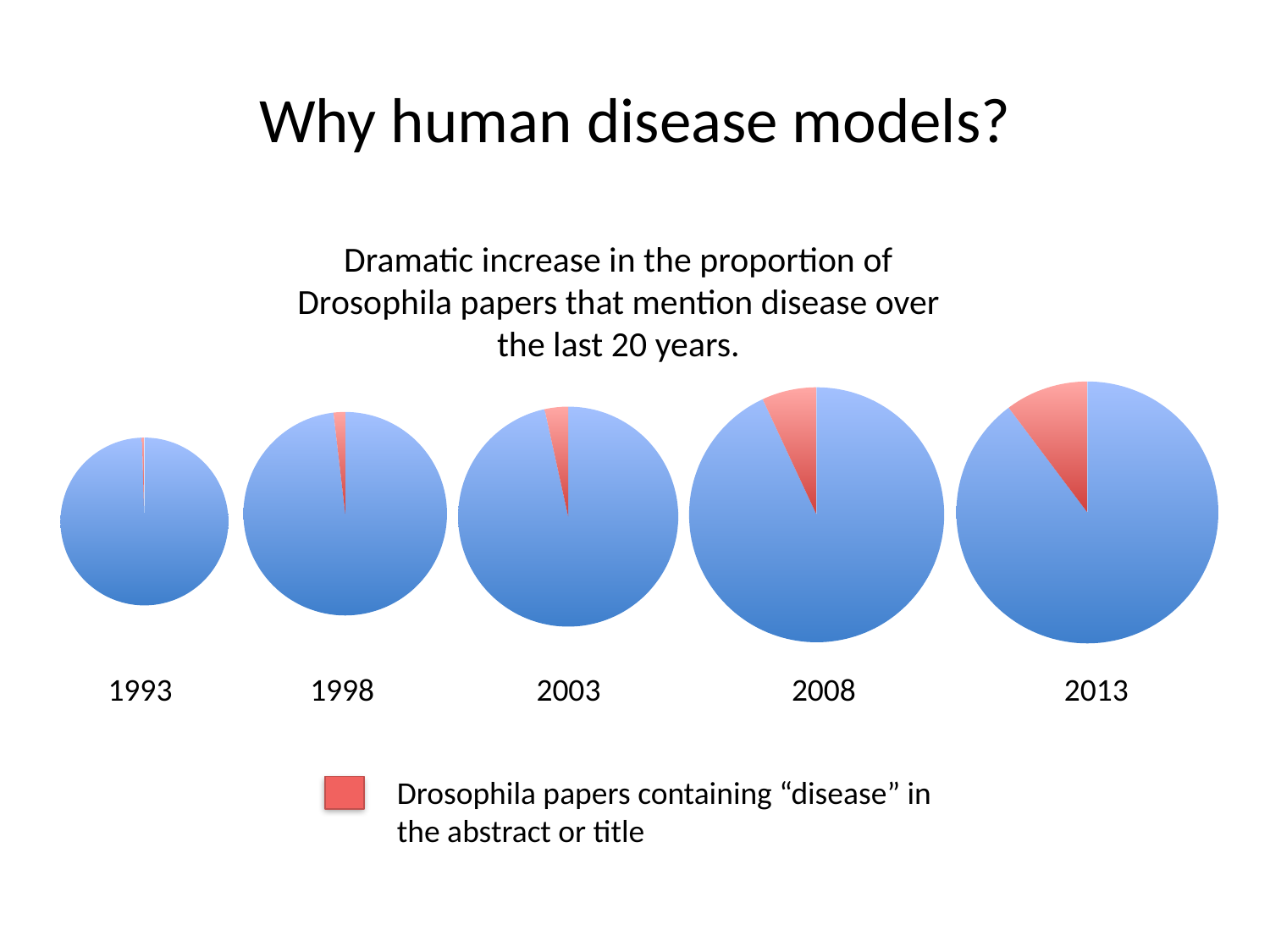
Is the red slice larger in the 2008 pie chart or the 1998 pie chart? 2008 Which years are labelled under the pie charts? 1993, 1998, 2003, 2008, 2013 Does the red share of the pie charts rise or fall from 1993 to 2013? rise How many pie charts are shown on the slide? 5 Is the red slice larger in the 2003 pie chart or the 2013 pie chart? 2013 Which year's pie chart is the largest in size on the slide? 2013 According to the legend, what does the red slice in each pie chart represent? Drosophila papers containing "disease" in the abstract or title Which year's pie chart has the largest red slice? 2013 Which year's pie chart has the smallest red slice? 1993 What kind of chart is used for each year on the slide? pie chart